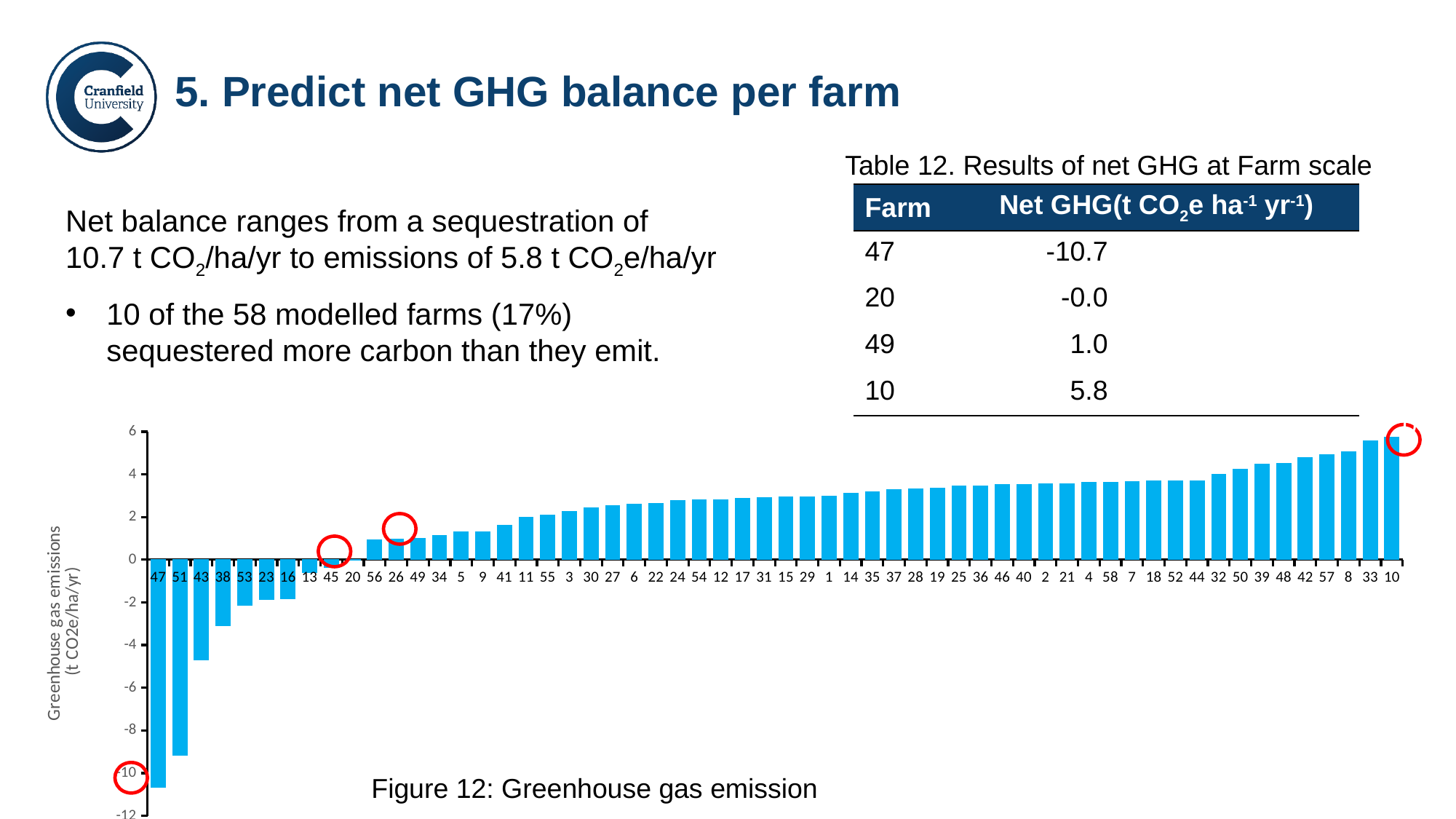
What is the net GHG value for farm 47? -10.7 Which farm has the lowest (most negative) greenhouse gas emissions in Figure 12? 47 What is the net GHG value for farm 10? 5.8 What is the y-axis label of Figure 12? Greenhouse gas emissions (t CO2e/ha/yr) Which farm has the highest greenhouse gas emissions in Figure 12? 10 What kind of chart is Figure 12? bar chart Is the value for farm 33 greater or less than 4? greater What is the difference between the net GHG values of farm 10 and farm 47? 16.5 Do the bar values rise or fall from left to right along the x axis in Figure 12? rise How many farms (bars) are plotted in Figure 12? 58 What is the net GHG value for farm 49? 1.0 Is the value for farm 51 greater or less than -8? less